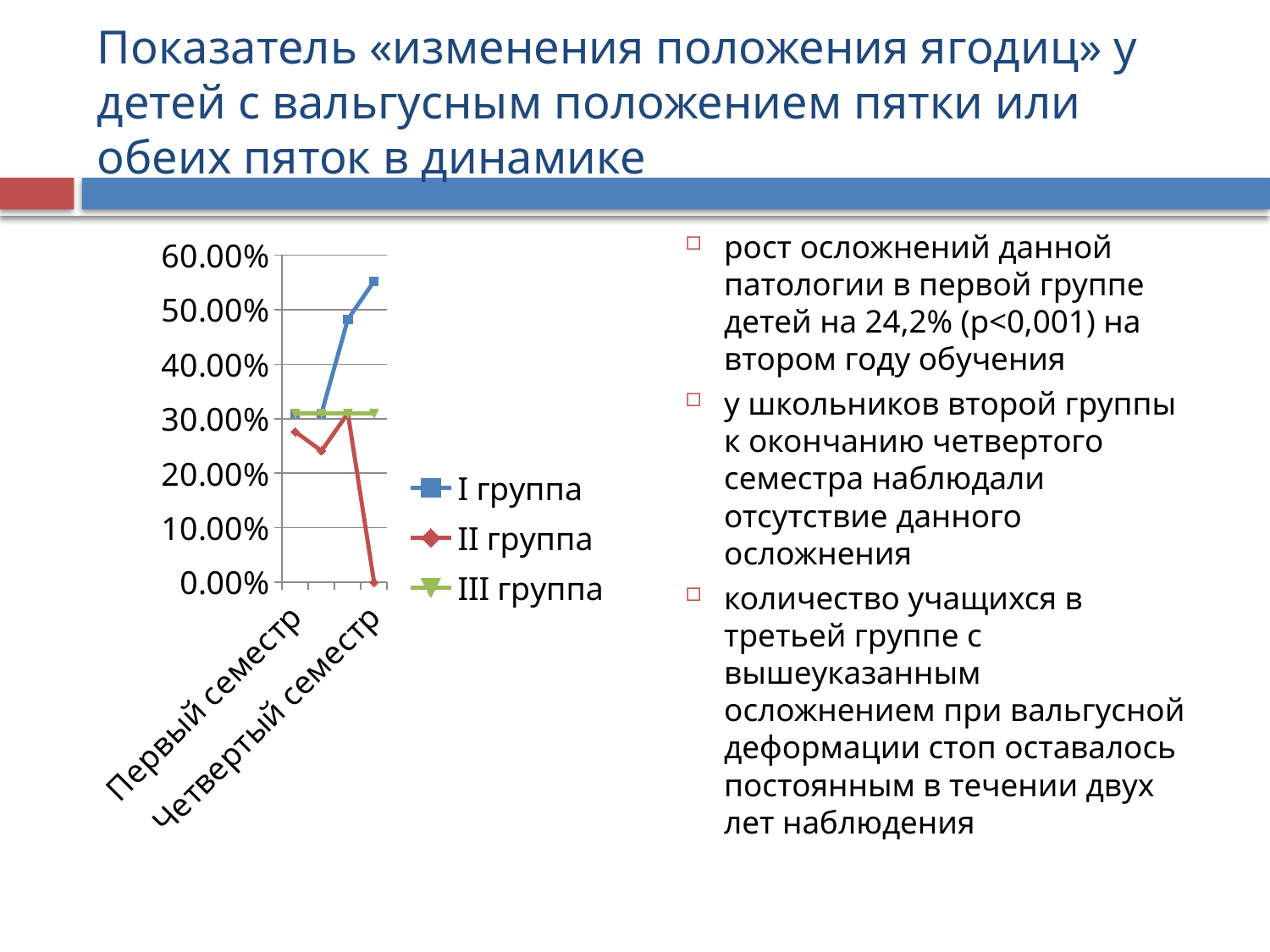
Is the value for II группа at Первый семестр greater or less than 30.00%? less Is the value for I группа at Четвертый семестр greater or less than 50.00%? greater How many series does the chart legend list? 3 What kind of chart is shown on the slide? line chart Which series has the lowest value at Четвертый семестр? II группа Which series has the highest value at Четвертый семестр? I группа What is the highest tick value shown on the vertical axis of the chart? 60.00% Is the value for III группа at Первый семестр greater or less than 40.00%? less At Четвертый семестр, which is larger: the value for I группа or the value for II группа? I группа Does the value for I группа rise or fall from Первый семестр to Четвертый семестр? rise What is the value for II группа at Четвертый семестр? 0.00% What are the three series named in the chart legend? I группа, II группа, III группа